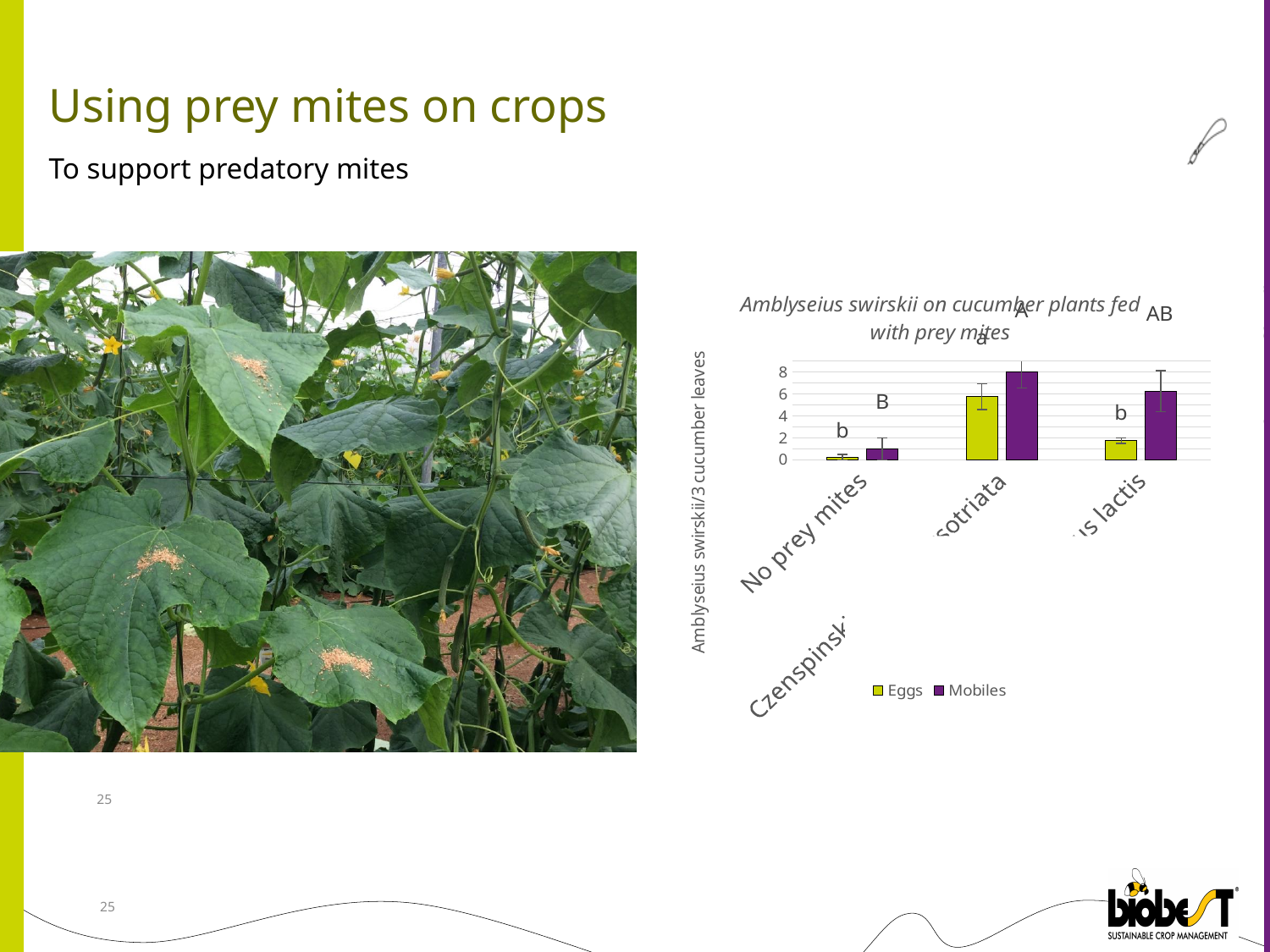
Is the Eggs value for No prey mites greater or less than 2? less What is the title of the chart? Amblyseius swirskii on cucumber plants fed with prey mites What kind of chart is shown on the slide? bar chart What are the two series named in the chart legend? Eggs and Mobiles How many series does the chart legend list? 2 Is the Mobiles value for No prey mites greater or less than 2? less For No prey mites, which is larger, the Eggs value or the Mobiles value? Mobiles Which category has the lowest Mobiles value? No prey mites Which category has the lowest Eggs value? No prey mites How many categories are shown on the x axis of the chart? 3